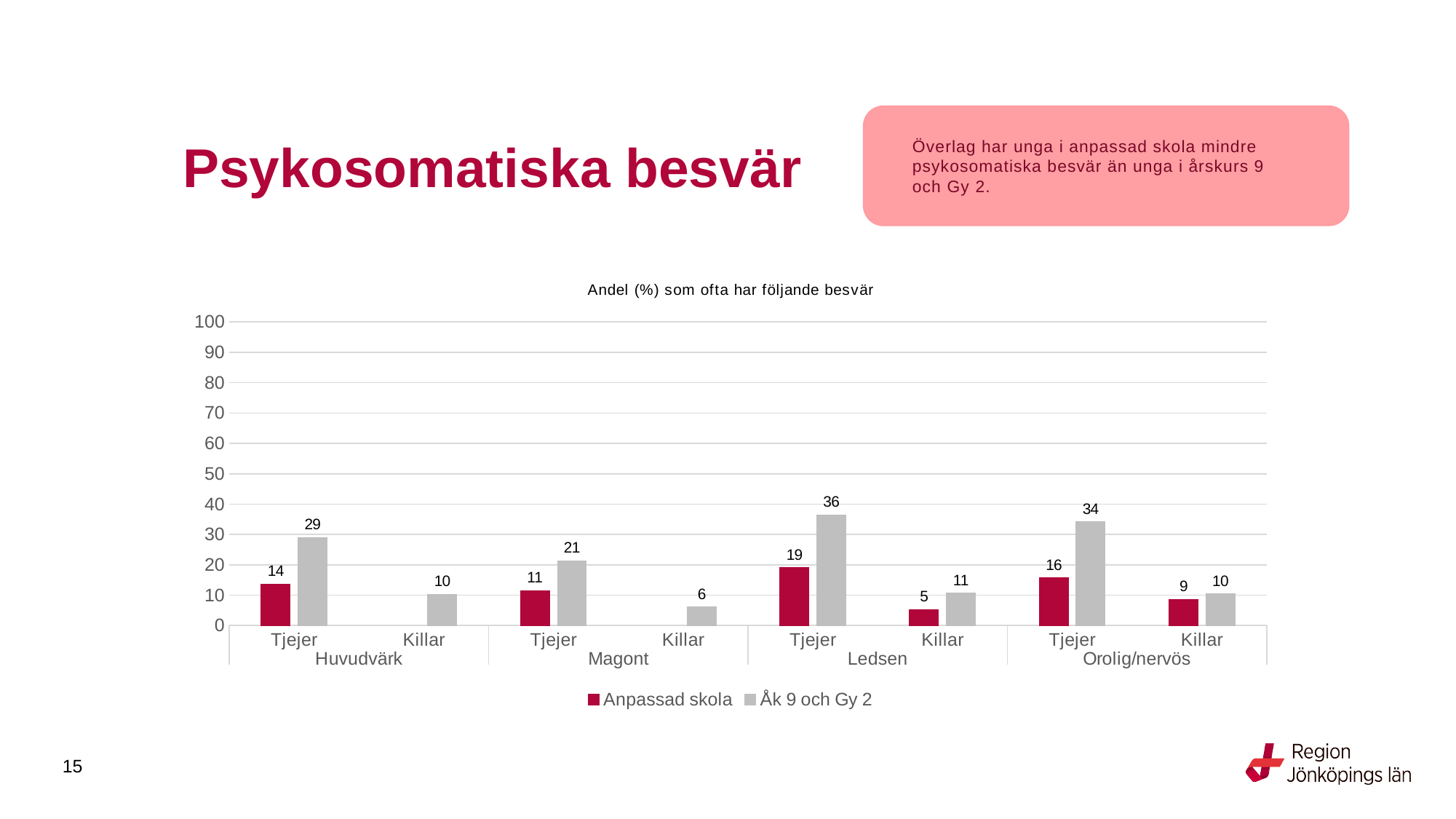
What is the title of the chart? Andel (%) som ofta har följande besvär What is the difference between Åk 9 och Gy 2 and Anpassad skola among Tjejer for Orolig/nervös? 18 What is the value for Åk 9 och Gy 2 among Tjejer for Ledsen? 36 What type of chart is shown on the slide? bar chart Which group has the highest value for Åk 9 och Gy 2? Tjejer, Ledsen How many series does the legend list? 2 Is the value for Åk 9 och Gy 2 among Tjejer for Huvudvärk greater or less than 20? greater Which group has the lowest value for Anpassad skola? Killar, Ledsen What is the value for Åk 9 och Gy 2 among Killar for Magont? 6 What is the value for Anpassad skola among Tjejer for Huvudvärk? 14 What is the value for Anpassad skola among Killar for Orolig/nervös? 9 Which is larger for Tjejer with Magont: Anpassad skola or Åk 9 och Gy 2? Åk 9 och Gy 2